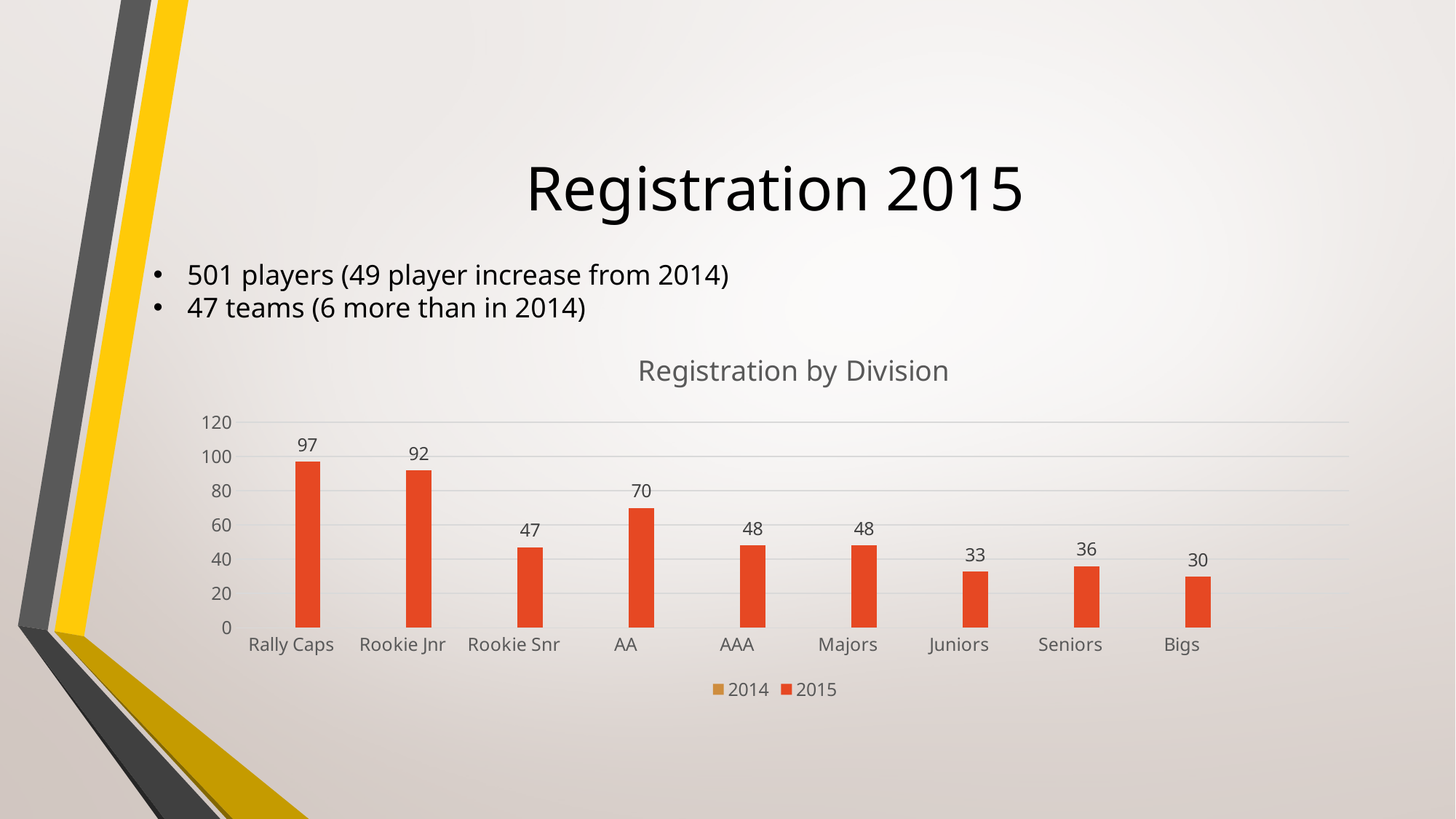
What is the difference between the 2015 registration for AA and Juniors? 37 Is the 2015 registration value for Rookie Jnr greater or less than 80? greater What is the difference between the 2015 registration for Rally Caps and Rookie Jnr? 5 What is the 2015 registration value for AA? 70 What is the 2015 registration value for Rally Caps in the Registration by Division chart? 97 How many divisions are shown on the x axis of the Registration by Division chart? 9 What is the 2015 registration value for Seniors? 36 Which division has the lowest 2015 registration? Bigs Which division has the highest 2015 registration? Rally Caps What type of chart is the Registration by Division chart? Bar chart Which has a larger 2015 registration, Rookie Snr or AA? AA How many series does the legend of the Registration by Division chart list? 2